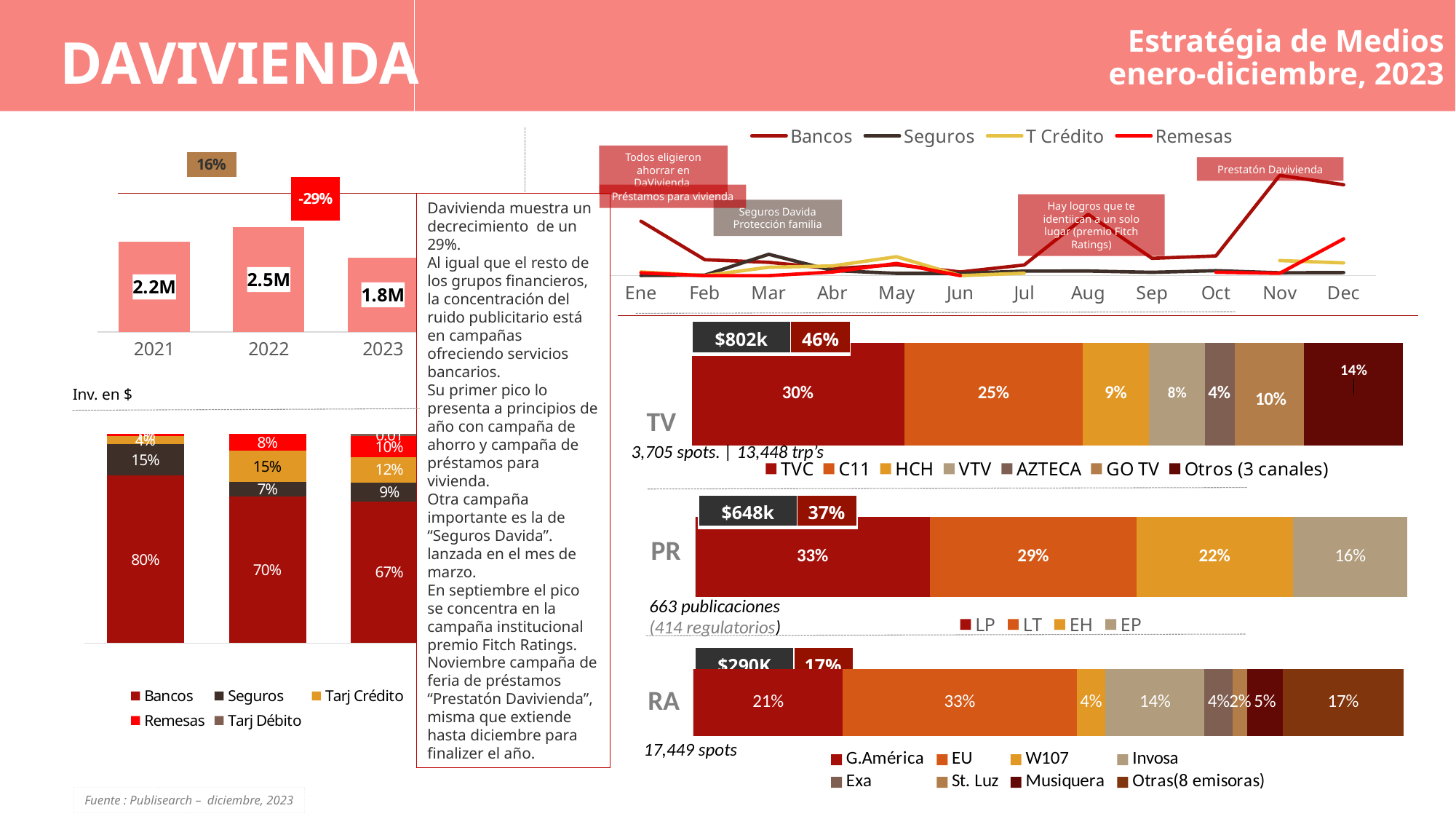
In the RA stacked bar, which station has the largest share? EU In the line chart at the top right, how many months are shown on the x axis? 12 In the TV stacked bar, what share does C11 have? 25% In the TV stacked bar, which channel has the largest share? TVC In the 'Inv. en $' stacked bar chart, is the Bancos share larger in 2022 or in 2023? 2022 In the top-left bar chart of yearly investment, what is the value for 2022? 2.5M In the 'Inv. en $' stacked bar chart, how many series does the legend list? 5 In the top-left bar chart of yearly investment, what percentage change is shown above the 2023 bar? -29% In the top-left bar chart of yearly investment, which year has the lowest value? 2023 In the 'Inv. en $' stacked bar chart, what share does Bancos have in 2021? 80% In the PR stacked bar, what is the difference between the LP and EP shares? 17% In the top-left bar chart of yearly investment, what is the difference between the 2022 and 2023 values? 0.7M